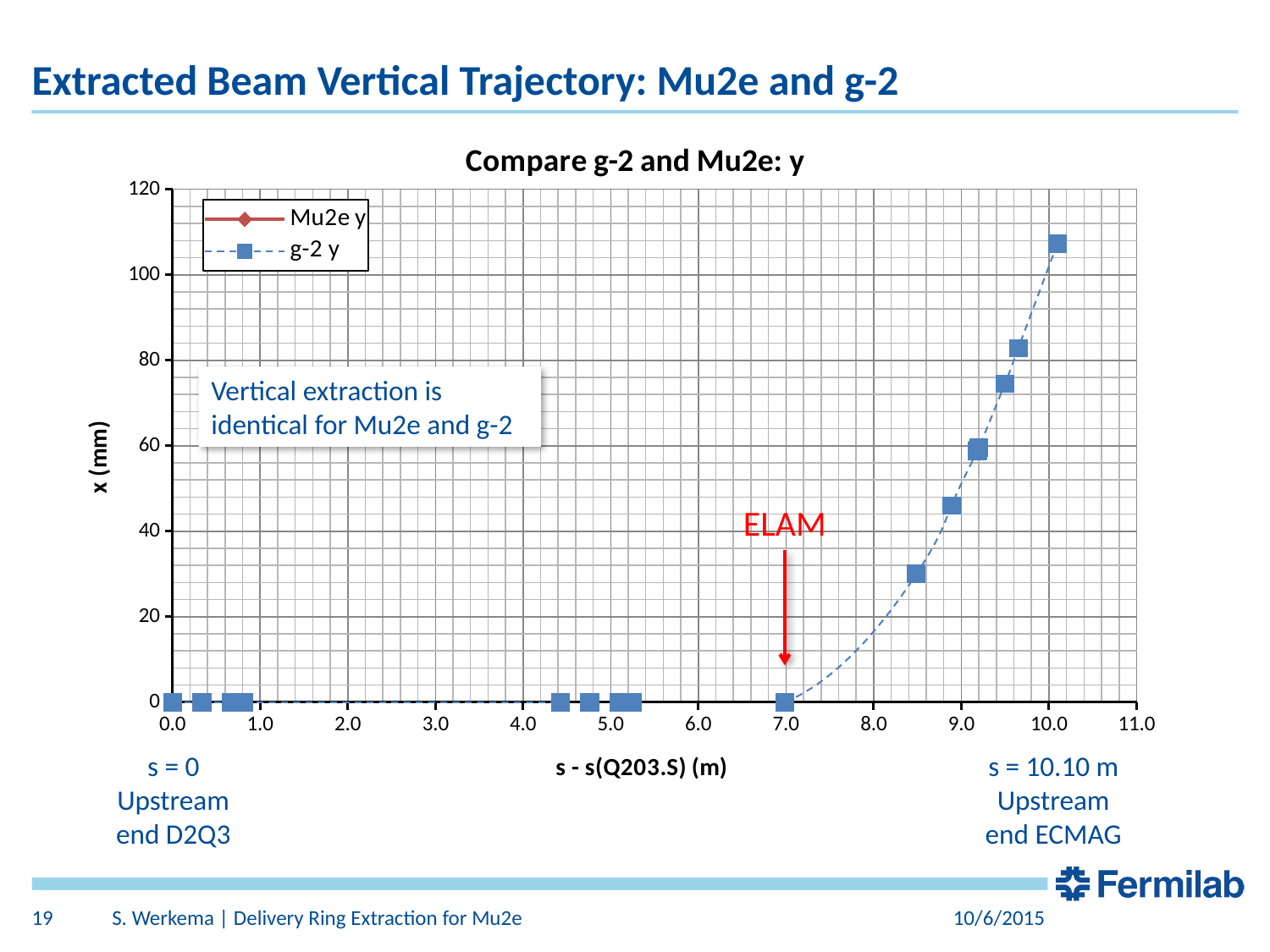
What is the title of the chart? Compare g-2 and Mu2e: y What kind of chart is shown on the slide? line chart What is the maximum value shown on the y axis? 120 Is the g-2 y value at about 8.9 m greater or less than 40? greater Is the highest plotted g-2 y value greater or less than 100? greater What is the g-2 y value at s - s(Q203.S) = 7.0 m, where the ELAM arrow points? 0 Do the plotted y values rise or fall as s - s(Q203.S) increases beyond 7.0 m? rise Which is larger, the g-2 y value at about 8.5 m or at about 10.1 m? at about 10.1 m How many series does the chart legend list? 2 What is the label of the y axis? x (mm) Is the g-2 y value at about 8.5 m greater or less than 20? greater